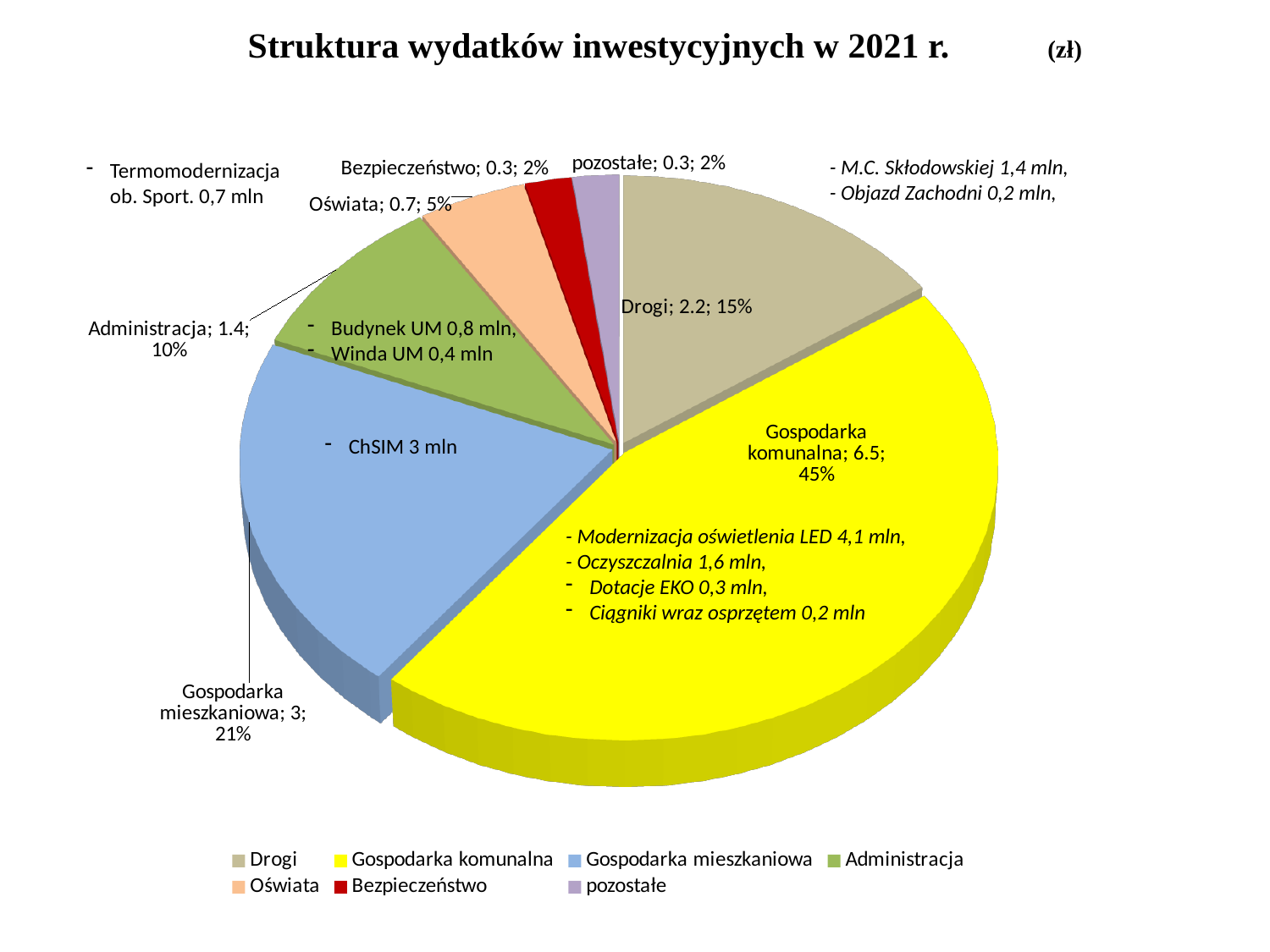
What is the value shown for Gospodarka komunalna? 6.5 Which category has the largest slice of the pie chart? Gospodarka komunalna How many categories does the legend list? 7 What percentage share does Gospodarka mieszkaniowa have in the pie chart? 21% What percentage share does Bezpieczeństwo have in the pie chart? 2% What type of chart is shown on the slide? pie chart What is the title of the chart? Struktura wydatków inwestycyjnych w 2021 r. (zł) What is the value shown for Oświata? 0.7 Which is larger, the value for Drogi or the value for Administracja? Drogi What is the value shown for Drogi? 2.2 What is the difference between the values for Gospodarka komunalna and Gospodarka mieszkaniowa? 3.5 What percentage share does Administracja have in the pie chart? 10%